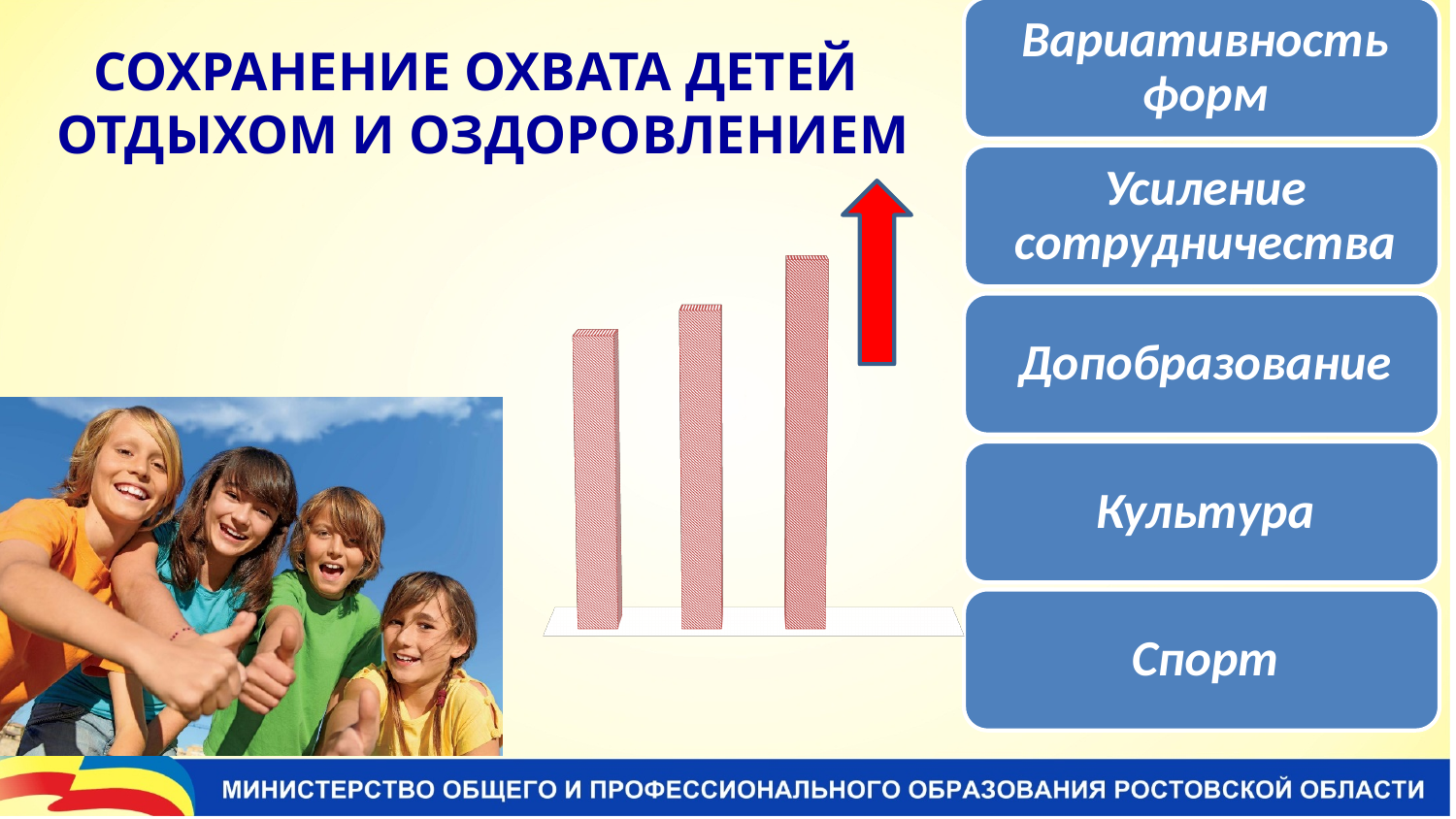
Does the chart display a legend? No Is the rightmost bar taller or shorter than the middle bar? taller Do the bar values rise or fall from left to right across the chart? rise What kind of chart is shown on the slide? bar chart Are any numeric data labels printed on the bars of the chart? No Which bar is the tallest in the chart: the leftmost, the middle, or the rightmost? the rightmost Which bar is the shortest in the chart: the leftmost, the middle, or the rightmost? the leftmost Is the middle bar taller or shorter than the leftmost bar? taller How many bars does the chart contain? 3